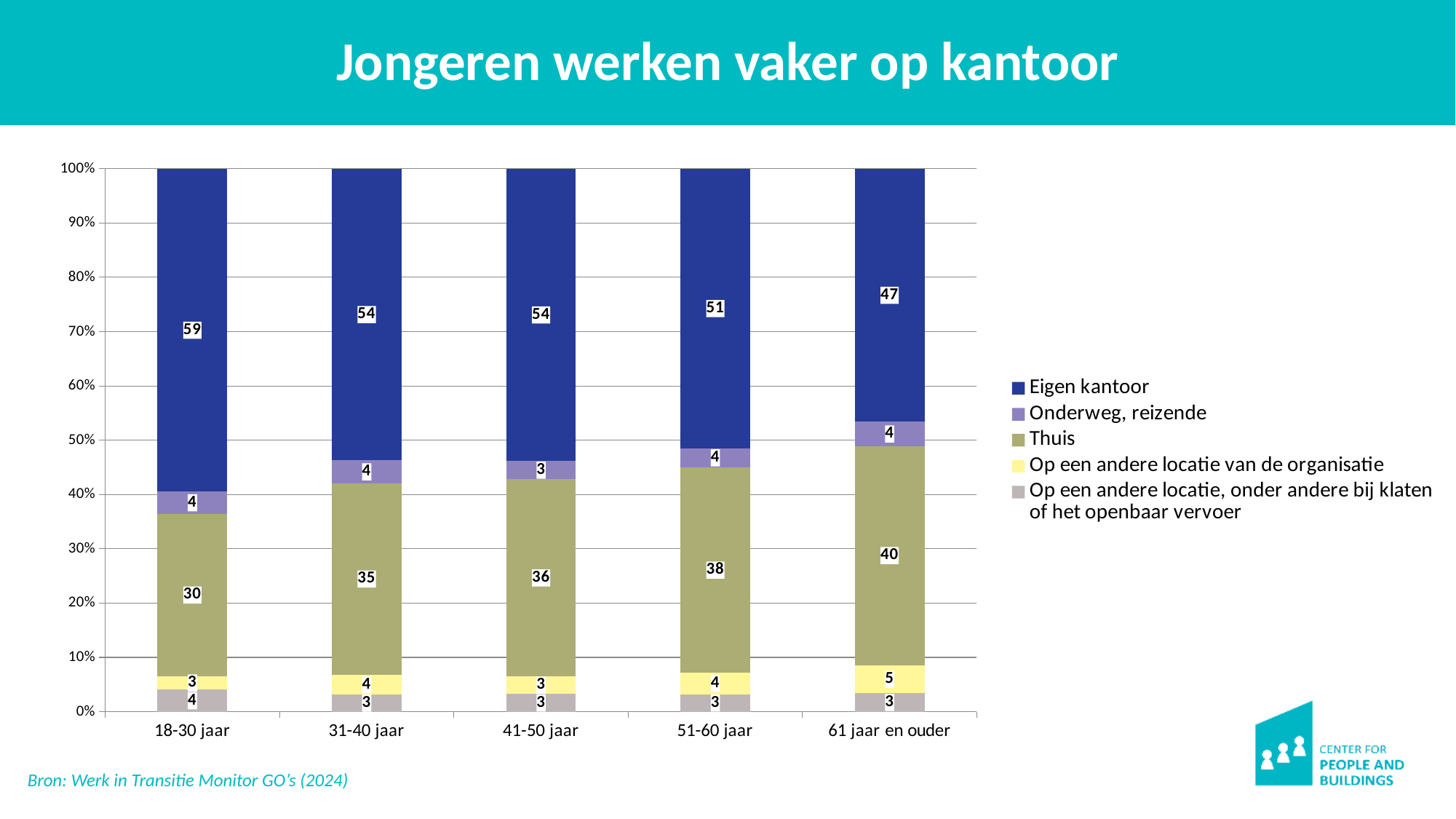
What is the value for Eigen kantoor in the 18-30 jaar category? 59 What is the difference between the Eigen kantoor values for 18-30 jaar and 61 jaar en ouder? 12 Do the Eigen kantoor values rise or fall from 18-30 jaar to 61 jaar en ouder? Fall How many age categories are shown on the x axis? 5 How many series does the legend list? 5 Which is larger: the Thuis value for 51-60 jaar or for 41-50 jaar? 51-60 jaar What is the value for Op een andere locatie van de organisatie in the 61 jaar en ouder category? 5 What kind of chart is shown on the slide? Stacked bar chart Which age category has the lowest value for Thuis? 18-30 jaar What is the title of the slide? Jongeren werken vaker op kantoor What is the value for Thuis in the 61 jaar en ouder category? 40 Which age category has the highest value for Eigen kantoor? 18-30 jaar